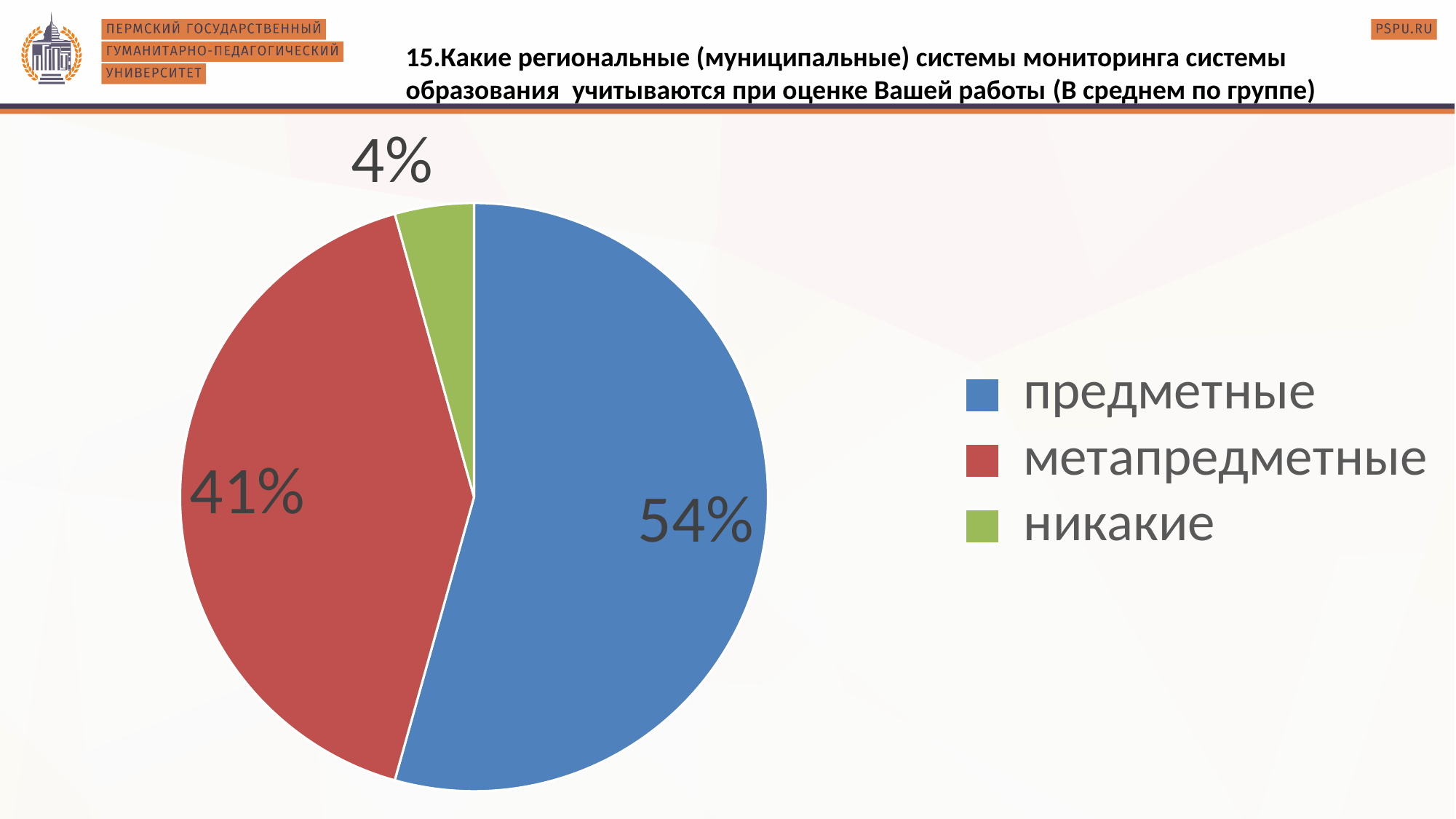
Which category has the smallest slice of the pie? никакие What is the difference in percentage points between the "предметные" and "метапредметные" slices? 13 What is the difference in percentage points between the "метапредметные" and "никакие" slices? 37 What share of the pie does the "никакие" slice represent? 4% What type of chart is shown on the slide? pie chart What share of the pie does the "метапредметные" slice represent? 41% What colour is the "никакие" slice? green What share of the pie does the "предметные" slice represent? 54% How many entries does the legend list? 3 Which category has the largest slice of the pie? предметные Which slice is larger, "предметные" or "метапредметные"? предметные How many slices does the pie chart have? 3